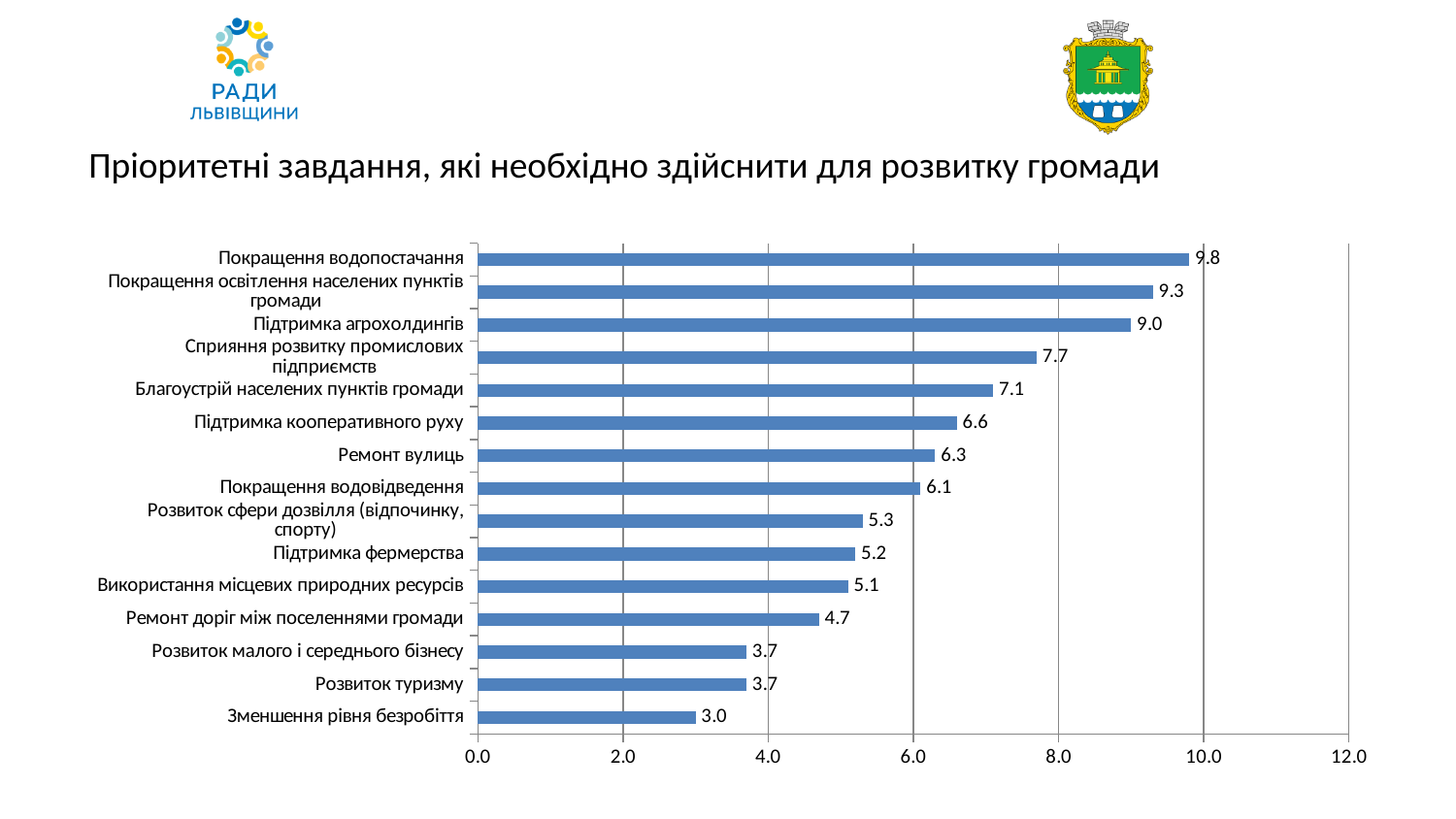
What kind of chart is shown on the slide? bar chart What is the value for Ремонт доріг між поселеннями громади? 4.7 Which category has the lowest value? Зменшення рівня безробіття What is the difference between the values for Покращення водопостачання and Зменшення рівня безробіття? 6.8 What is the difference between the values for Підтримка агрохолдингів and Благоустрій населених пунктів громади? 1.9 Is the value for Сприяння розвитку промислових підприємств greater or less than 8.0? less How many categories are shown in the chart? 15 Which is larger: the value for Підтримка кооперативного руху or the value for Покращення водовідведення? Підтримка кооперативного руху What is the value for Покращення водопостачання? 9.8 Which category has the highest value? Покращення водопостачання What is the value for Ремонт вулиць? 6.3 What is the value for Підтримка фермерства? 5.2